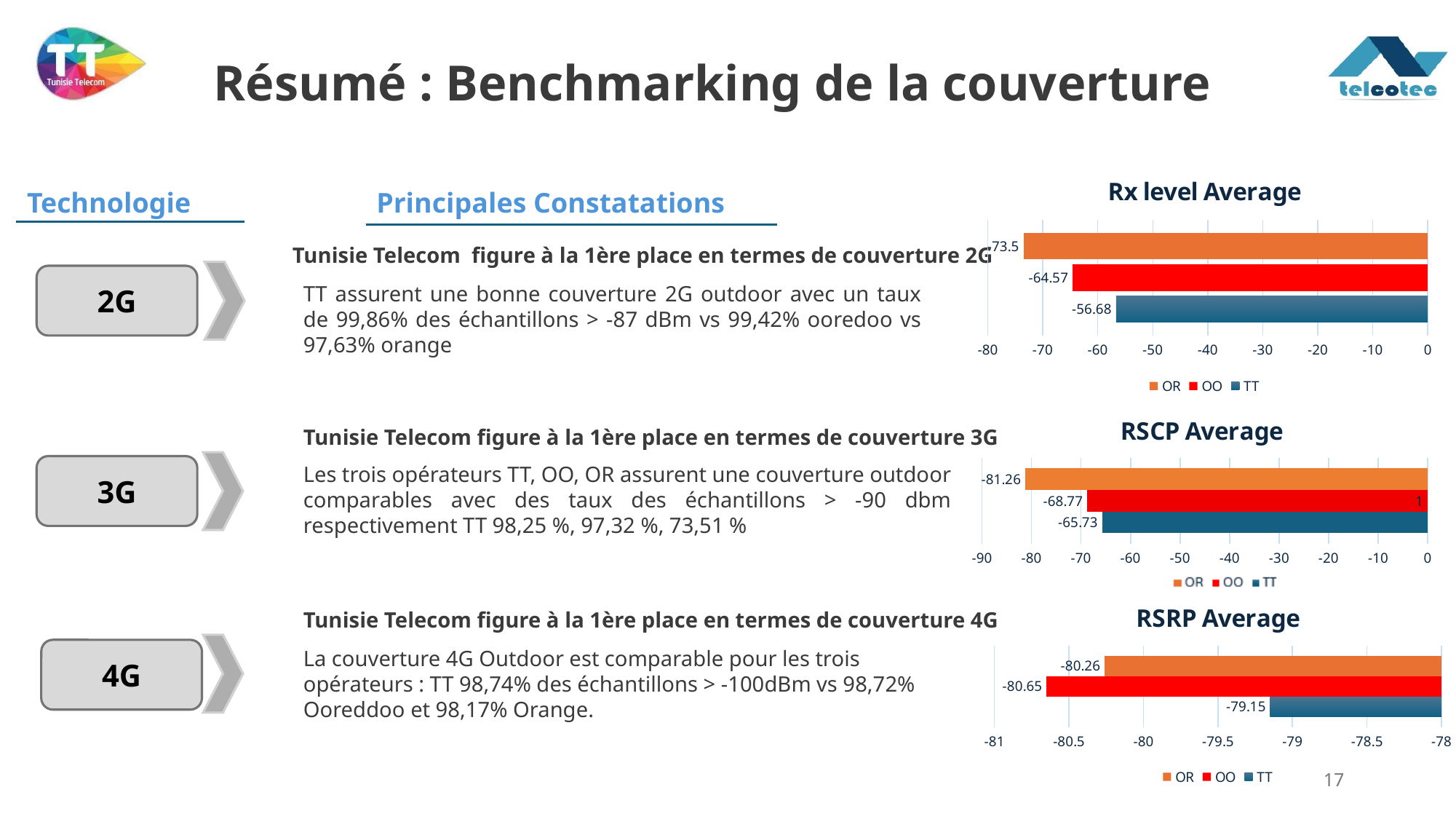
In the RSRP Average chart, which series has the lowest (most negative) value? OO In the RSCP Average chart, what is the value for OR? -81.26 In the RSRP Average chart, what is the value for TT? -79.15 In the RSCP Average chart, what is the difference between the OO value and the TT value? 3.04 What type of chart is the Rx level Average chart? bar chart In the Rx level Average chart, what is the value for TT? -56.68 In the RSCP Average chart, what is the value for TT? -65.73 How many series does the legend of the RSRP Average chart list? 3 In the RSRP Average chart, what is the value for OO? -80.65 In the Rx level Average chart, what is the value for OO? -64.57 In the Rx level Average chart, is the value for OR greater or less than -70? less In the RSCP Average chart, which series has the highest (least negative) value? TT